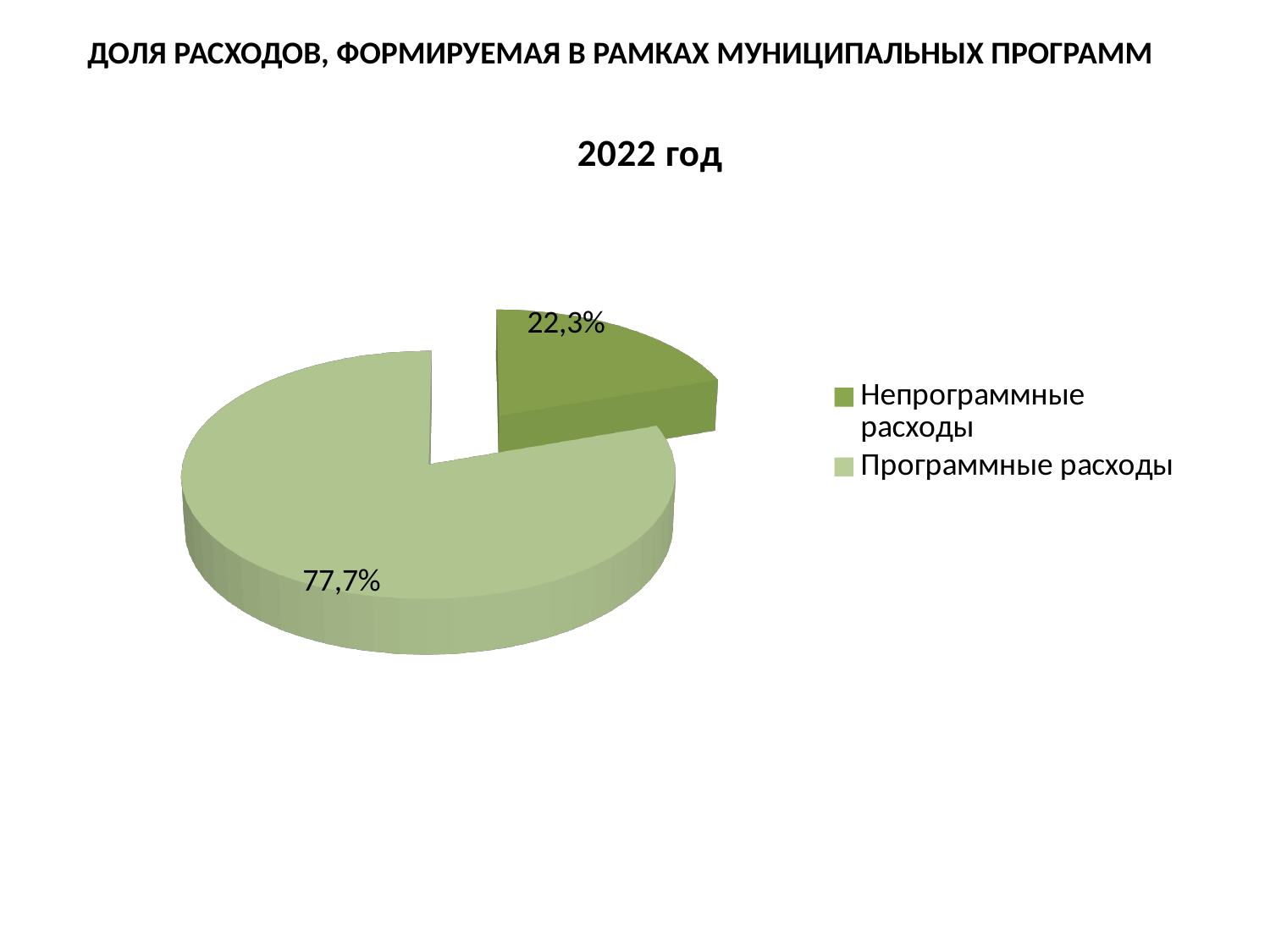
How many slices does the pie chart have? 2 Which category has the smallest slice? Непрограммные расходы Which category has the largest slice? Программные расходы What share of the pie is Непрограммные расходы? 22,3% Which legend entry is shown in the darker green colour? Непрограммные расходы What kind of chart is shown on the slide? Pie chart What is the difference between the shares of Программные расходы and Непрограммные расходы? 55,4% What is the chart's title? 2022 год What share of the pie is Программные расходы? 77,7% How many entries does the legend list? 2 Which is larger: Непрограммные расходы or Программные расходы? Программные расходы